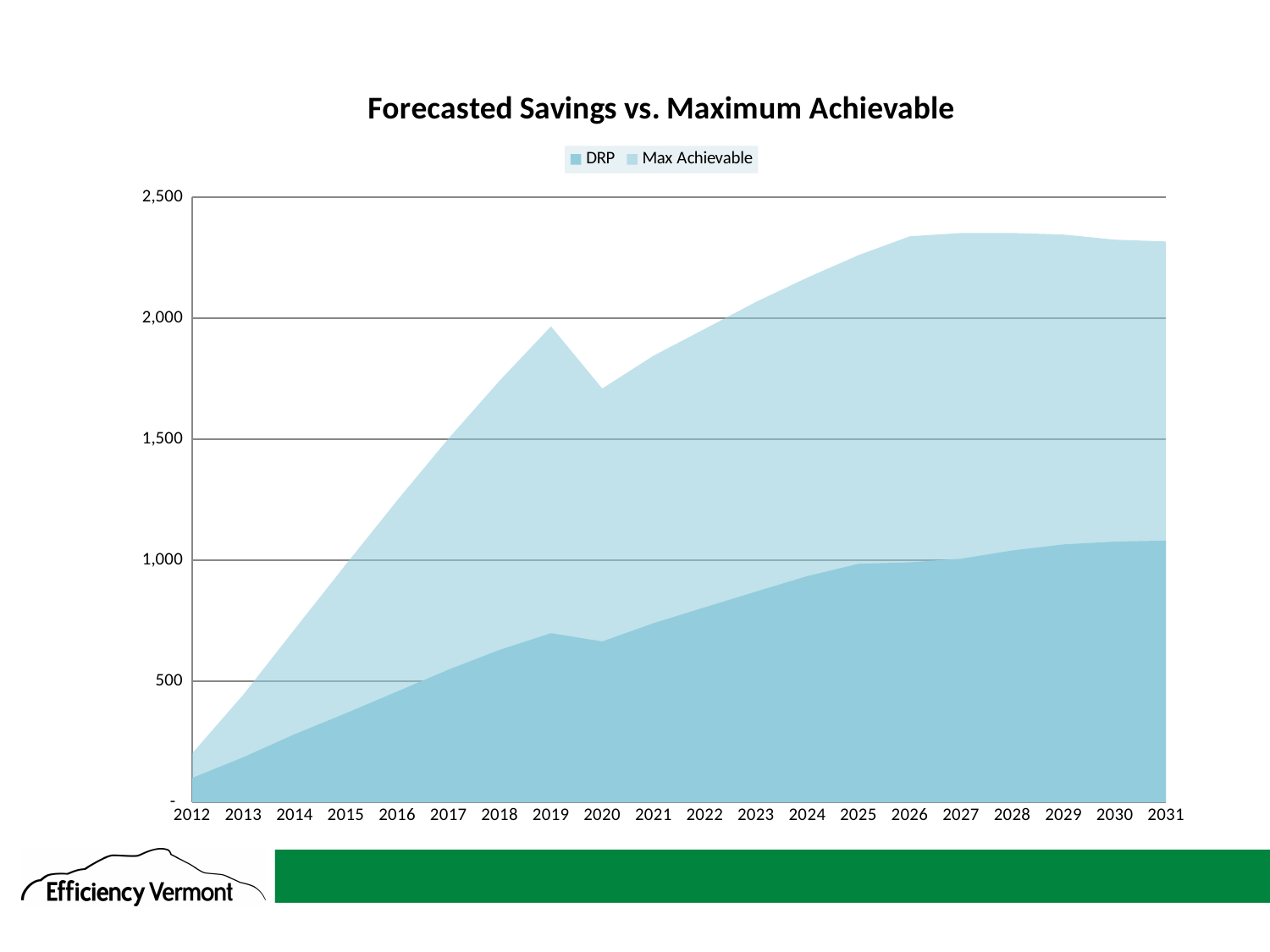
What is the title of the chart? Forecasted Savings vs. Maximum Achievable Is the Max Achievable value for 2031 greater or less than 2,000? greater Is the DRP value for 2020 greater or less than 1,000? less How many years are shown along the x axis? 20 In which year is the DRP value lowest? 2012 In which year is the Max Achievable value lowest? 2012 Is the Max Achievable value for 2020 greater or less than 1,500? greater In 2025, which series has the larger value, DRP or Max Achievable? Max Achievable Which two series are listed in the legend? DRP and Max Achievable How many series does the legend list? 2 Does the Max Achievable value rise or fall from 2019 to 2020? fall What kind of chart is shown on the slide? Area chart